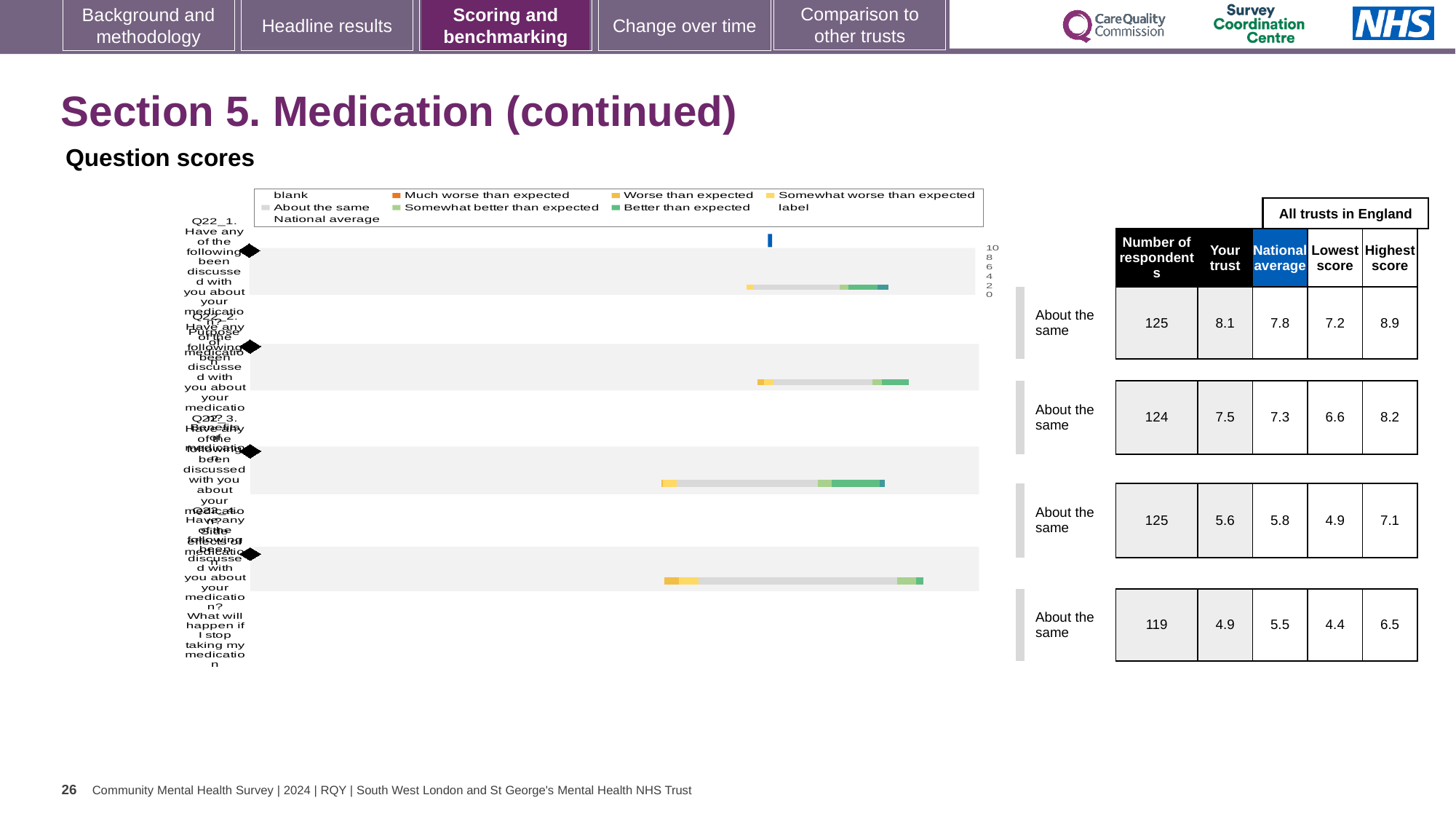
How many respondents are listed for the third row (Q22_3)? 125 For the third row (Q22_3), which is larger: the 'Your trust' score or the national average? National average What is the highest score among all trusts in England for the second row (Q22_2)? 8.2 What kind of chart is shown on the slide? bar chart How many questions (rows) are plotted in the chart? 4 What benchmark category is shown for the bottom row (Q22_4)? About the same For the second row (Q22_2), what is the difference between the 'Your trust' score and the national average? 0.2 What is the 'Your trust' score for the first row (Q22_1)? 8.1 What is the national average for the bottom row (Q22_4)? 5.5 What colour represents 'Much worse than expected' in the legend? Orange Which row has the highest 'Your trust' score? Q22_1 (first row) Which row has the lowest 'Your trust' score? Q22_4 (bottom row)